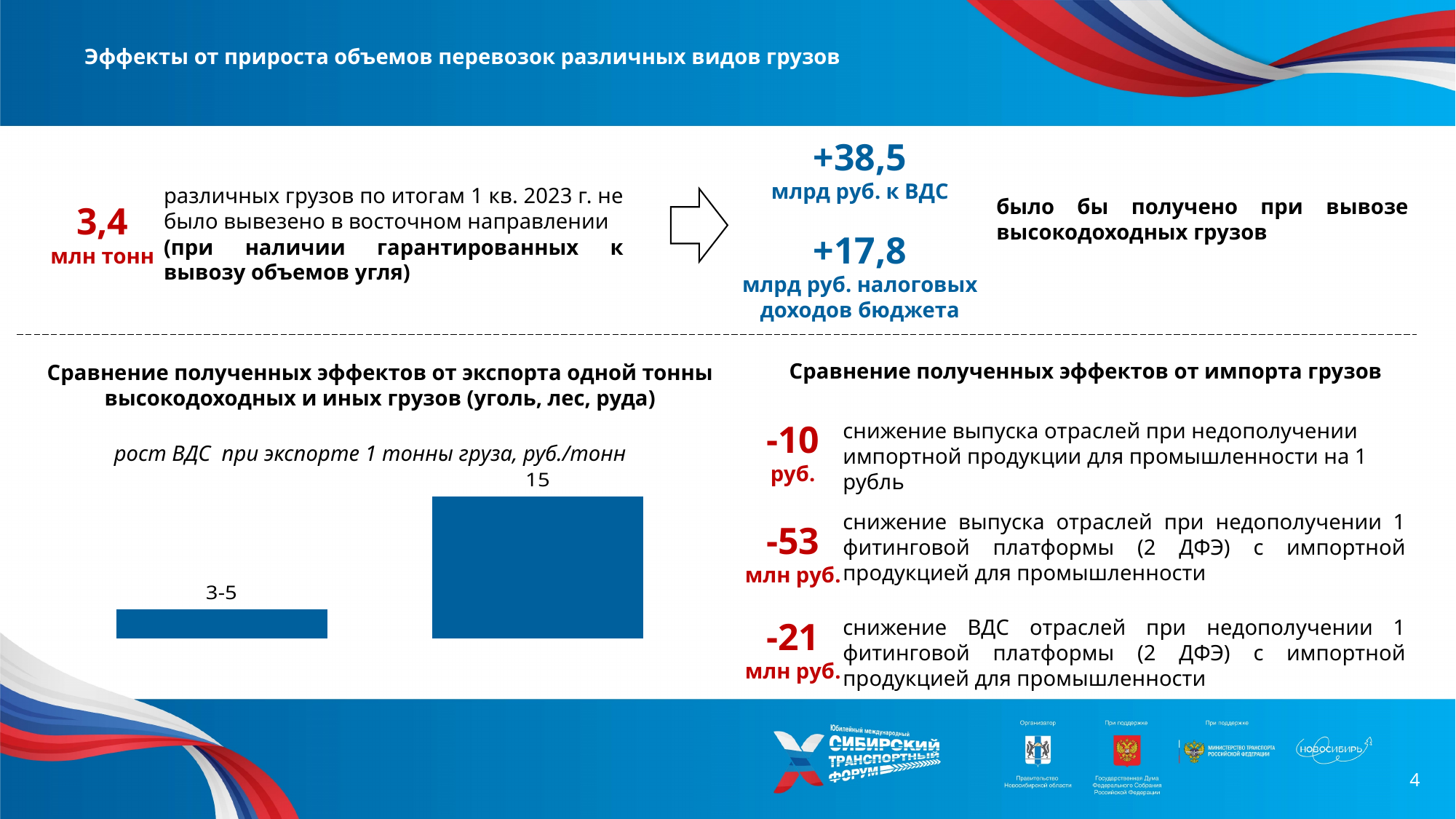
What is the data label on the left bar of the chart? 3-5 Which bar in the chart is the lowest, the left or the right one? the left bar What colour are the bars in the chart? blue Is the value of the left bar or the right bar larger? the right bar What is the data label on the right bar of the chart? 15 What kind of chart is shown on the slide? bar chart Which bar in the chart is the highest, the left or the right one? the right bar How many bars does the chart show? 2 What is the title of the chart? рост ВДС при экспорте 1 тонны груза, руб./тонн